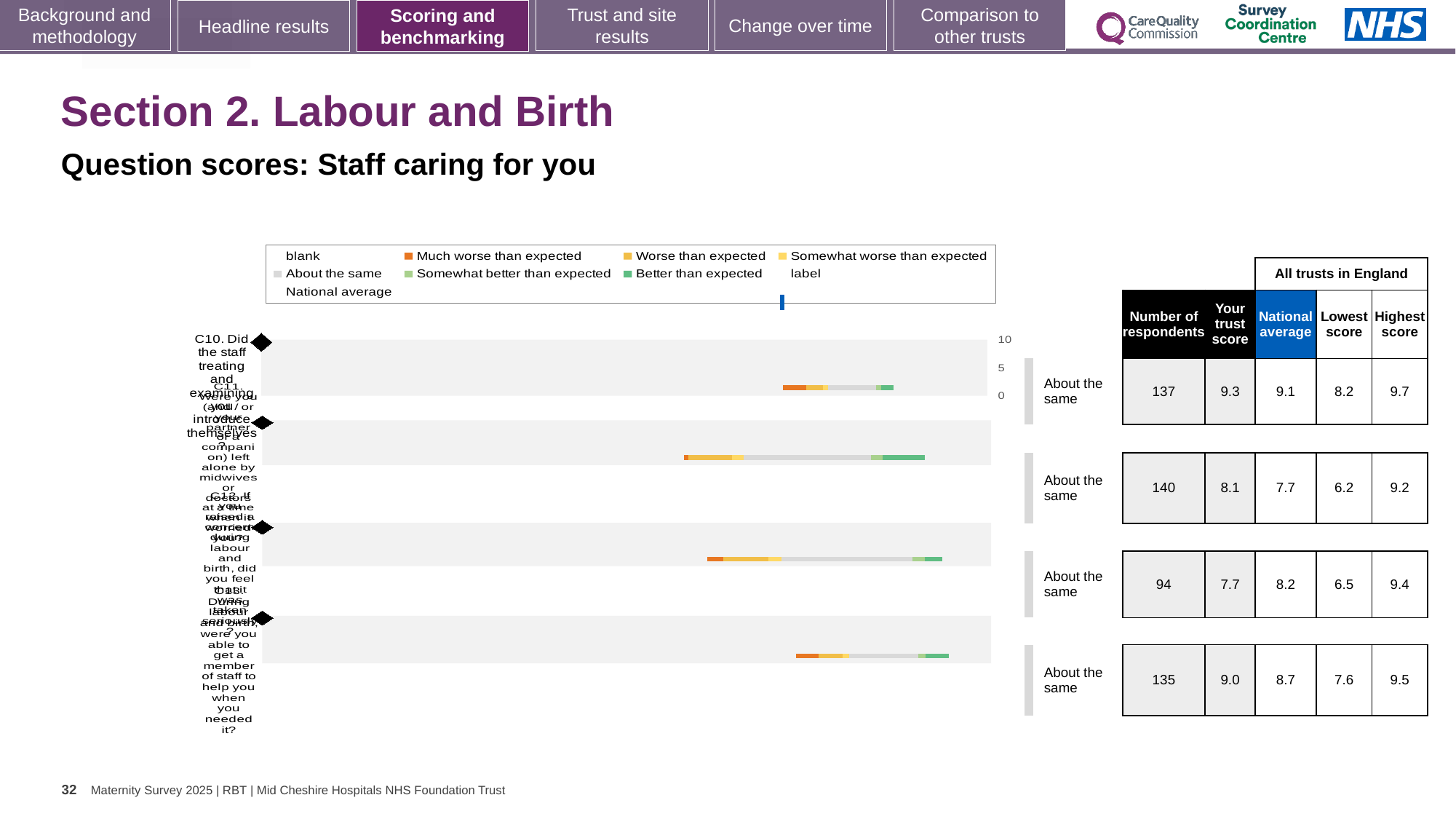
What kind of chart is shown on the slide? bar chart In the third row, which is larger: 'Your trust score' or the national average? national average Which row of the table has the lowest 'Your trust score'? the third row In the first (top) row, what is the difference between 'Your trust score' and the national average? 0.2 In the table next to the chart, what is the national average for the second row? 7.7 In the table next to the chart, what is the lowest score for the third row? 6.5 What heading appears above the National average, Lowest score and Highest score columns? All trusts in England In the table next to the chart, what is the highest score for the fourth (bottom) row? 9.5 How many question rows (bars) are plotted in the chart? 4 Which row of the table has the highest 'Your trust score'? the first (top) row In the table next to the chart, what is the 'Your trust score' value for the first (top) row? 9.3 In the table next to the chart, what is the number of respondents for the first (top) row? 137